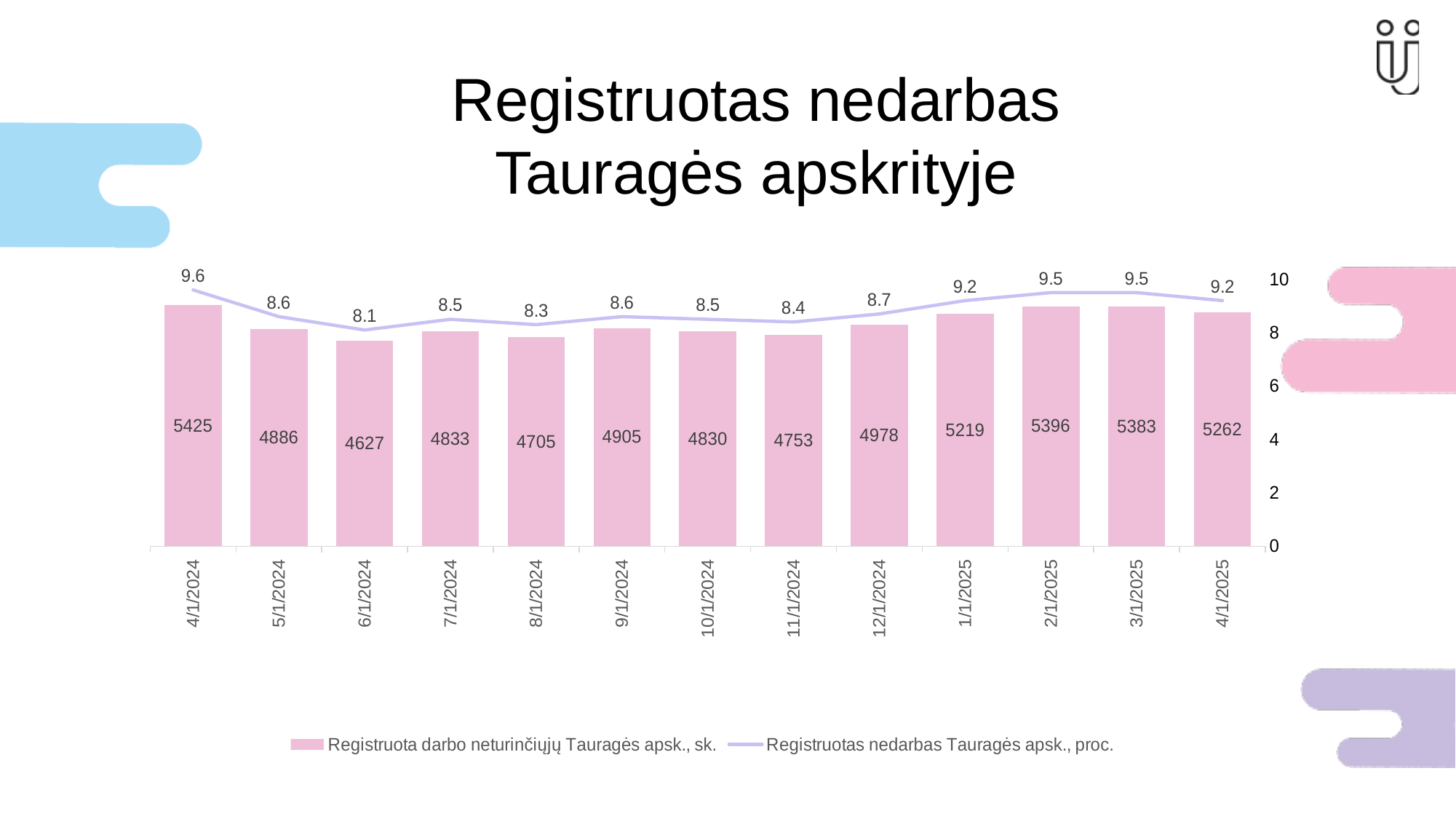
Which date has the highest value for 'Registruota darbo neturinčiųjų Tauragės apsk., sk.'? 4/1/2024 What is the value of 'Registruota darbo neturinčiųjų Tauragės apsk., sk.' for 6/1/2024? 4627 What is the difference between the 'Registruotas nedarbas Tauragės apsk., proc.' values for 4/1/2024 and 6/1/2024? 1.5 What is the difference between the 'Registruota darbo neturinčiųjų Tauragės apsk., sk.' values for 4/1/2024 and 6/1/2024? 798 What is the value of 'Registruotas nedarbas Tauragės apsk., proc.' for 1/1/2025? 9.2 Which date has the lowest value for 'Registruotas nedarbas Tauragės apsk., proc.'? 6/1/2024 How many dates are shown on the x axis of the chart? 13 How many series does the legend list? 2 Does the 'Registruota darbo neturinčiųjų Tauragės apsk., sk.' value rise or fall from 11/1/2024 to 2/1/2025? rise What is the value of 'Registruota darbo neturinčiųjų Tauragės apsk., sk.' for 2/1/2025? 5396 Which is larger, the 'Registruota darbo neturinčiųjų Tauragės apsk., sk.' value for 9/1/2024 or for 11/1/2024? 9/1/2024 What kind of chart is shown on the slide? A bar chart combined with a line chart